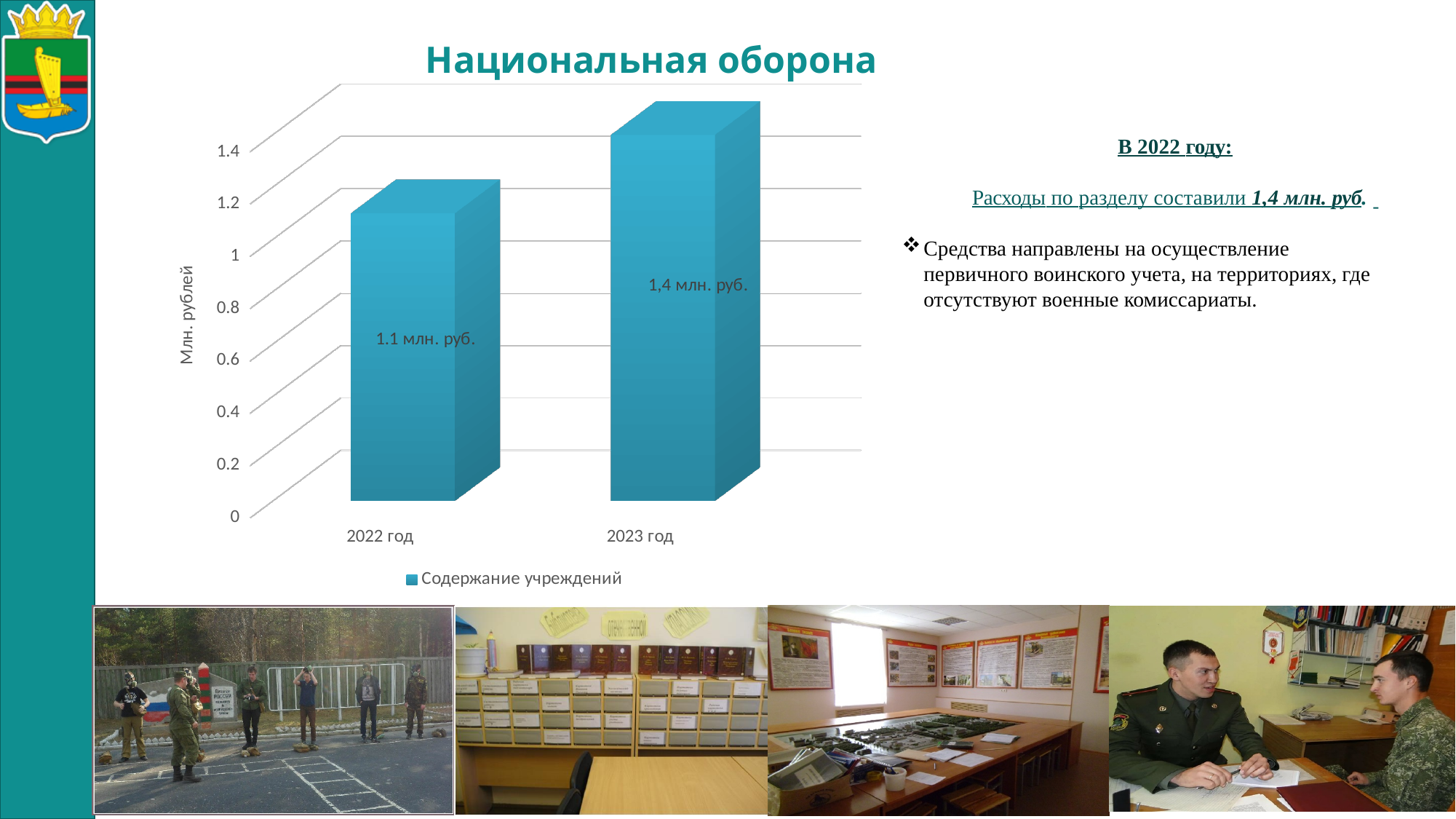
Which is larger, the value for 2022 год or 2023 год? 2023 год What is the value for 2023 год? 1,4 млн. руб. Which year has the highest value? 2023 год What kind of chart is shown on the slide? bar chart Which year has the lowest value? 2022 год Is the value for 2023 год greater or less than 1.2? greater How many categories are shown on the x axis? 2 Do the values rise or fall from 2022 год to 2023 год? rise Is the value for 2022 год greater or less than 1? greater What is the value for 2022 год? 1.1 млн. руб. How many series does the legend list? 1 What is the difference between the values for 2023 год and 2022 год? 0.3 млн. руб.